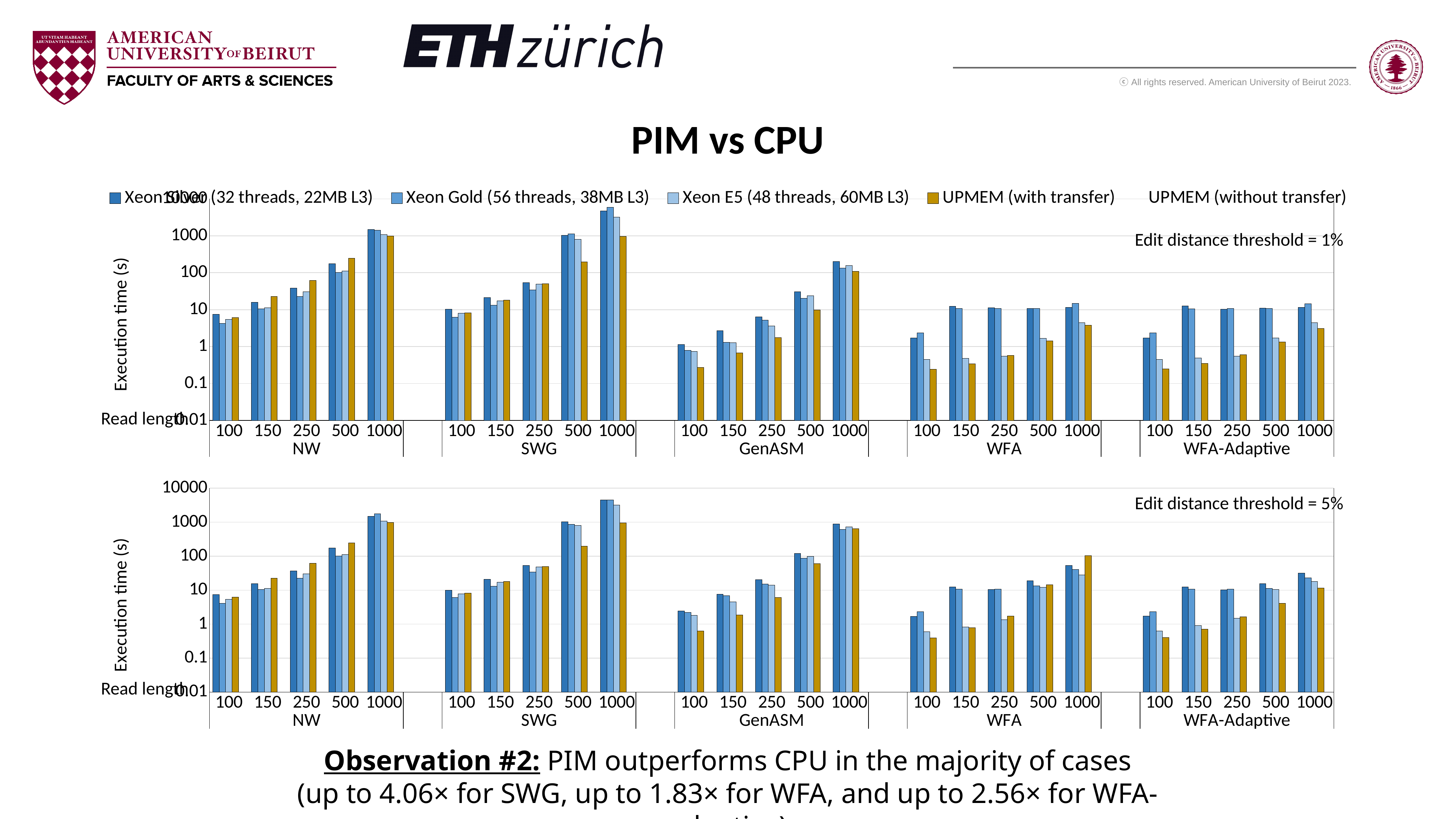
How many series does the legend list? 5 What is the y-axis label of the charts? Execution time (s) In the bottom chart (Edit distance threshold = 5%), does the Xeon Silver execution time for NW rise or fall as read length increases from 100 to 1000? rise What kind of chart is the top chart (Edit distance threshold = 1%)? bar chart How many algorithm groups are shown along the x axis of the bottom chart (Edit distance threshold = 5%)? 5 In the top chart (Edit distance threshold = 1%), is the UPMEM (with transfer) value for GenASM at read length 100 greater or less than 1? less In the top chart (Edit distance threshold = 1%), which read length in the SWG group has the highest Xeon Silver execution time? 1000 In the bottom chart (Edit distance threshold = 5%), is the UPMEM (with transfer) value for SWG at read length 500 greater or less than 100? greater In the bottom chart (Edit distance threshold = 5%), for WFA at read length 1000, which is larger: UPMEM (with transfer) or Xeon Silver? UPMEM (with transfer) In the top chart (Edit distance threshold = 1%), how many read lengths are plotted for the NW group? 5 In the top chart (Edit distance threshold = 1%), is the Xeon Silver value for SWG at read length 1000 greater or less than 1000? greater In the top chart (Edit distance threshold = 1%), for SWG at read length 500, which is larger: Xeon Silver or UPMEM (with transfer)? Xeon Silver